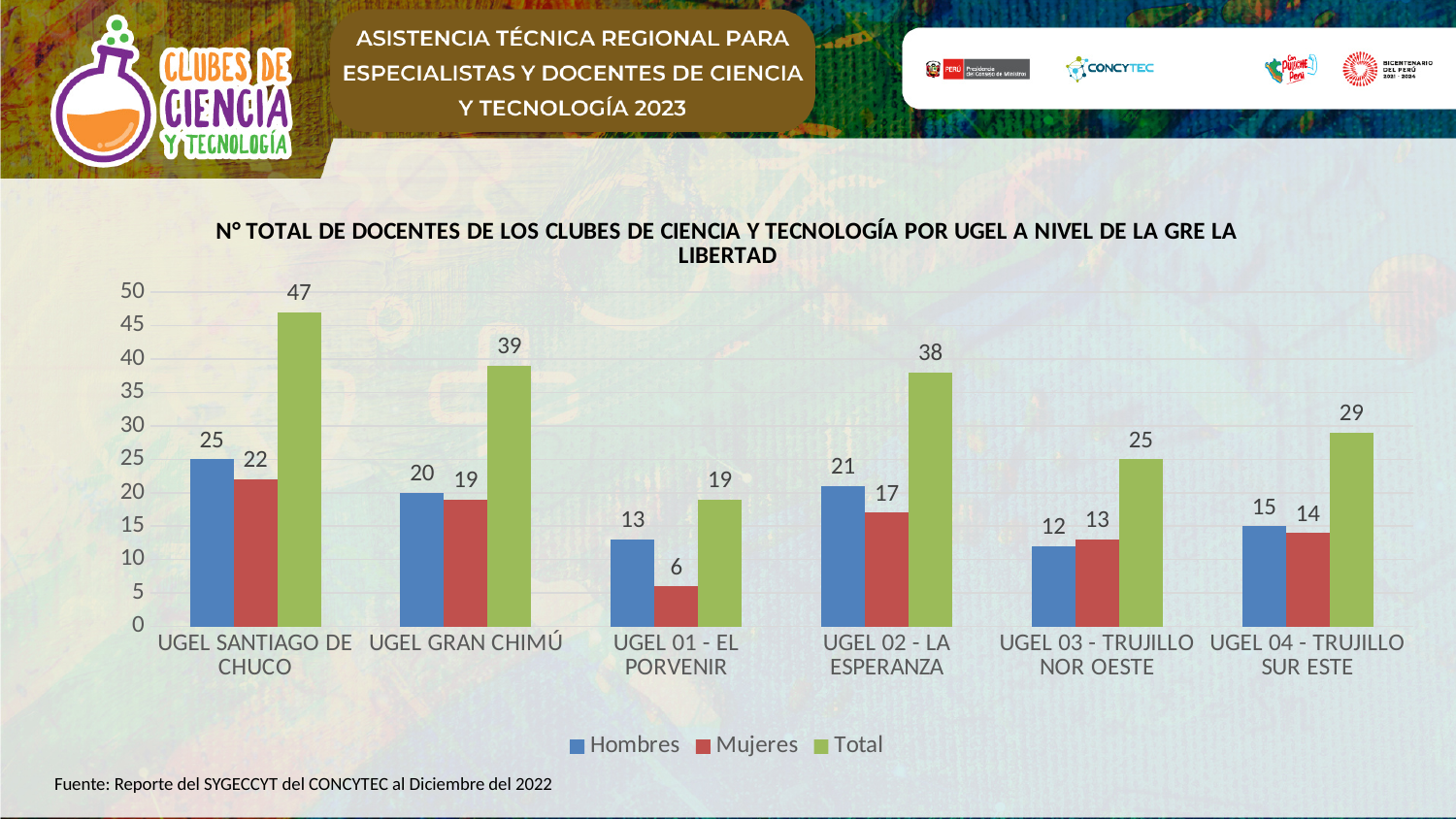
What is the Total value for UGEL SANTIAGO DE CHUCO? 47 What is the Hombres value for UGEL 02 - LA ESPERANZA? 21 Which is larger, the Hombres value for UGEL GRAN CHIMÚ or the Hombres value for UGEL 04 - TRUJILLO SUR ESTE? UGEL GRAN CHIMÚ What kind of chart is shown on the slide? Bar chart What is the difference between the Hombres and Mujeres values for UGEL 01 - EL PORVENIR? 7 What is the Mujeres value for UGEL 01 - EL PORVENIR? 6 How many UGEL categories are shown on the x axis? 6 What colour represents the Total series in the chart? Green How many series does the legend list? 3 Which UGEL has the lowest Hombres value? UGEL 03 - TRUJILLO NOR OESTE Which UGEL has the lowest Total value? UGEL 01 - EL PORVENIR Which UGEL has the highest Total value? UGEL SANTIAGO DE CHUCO